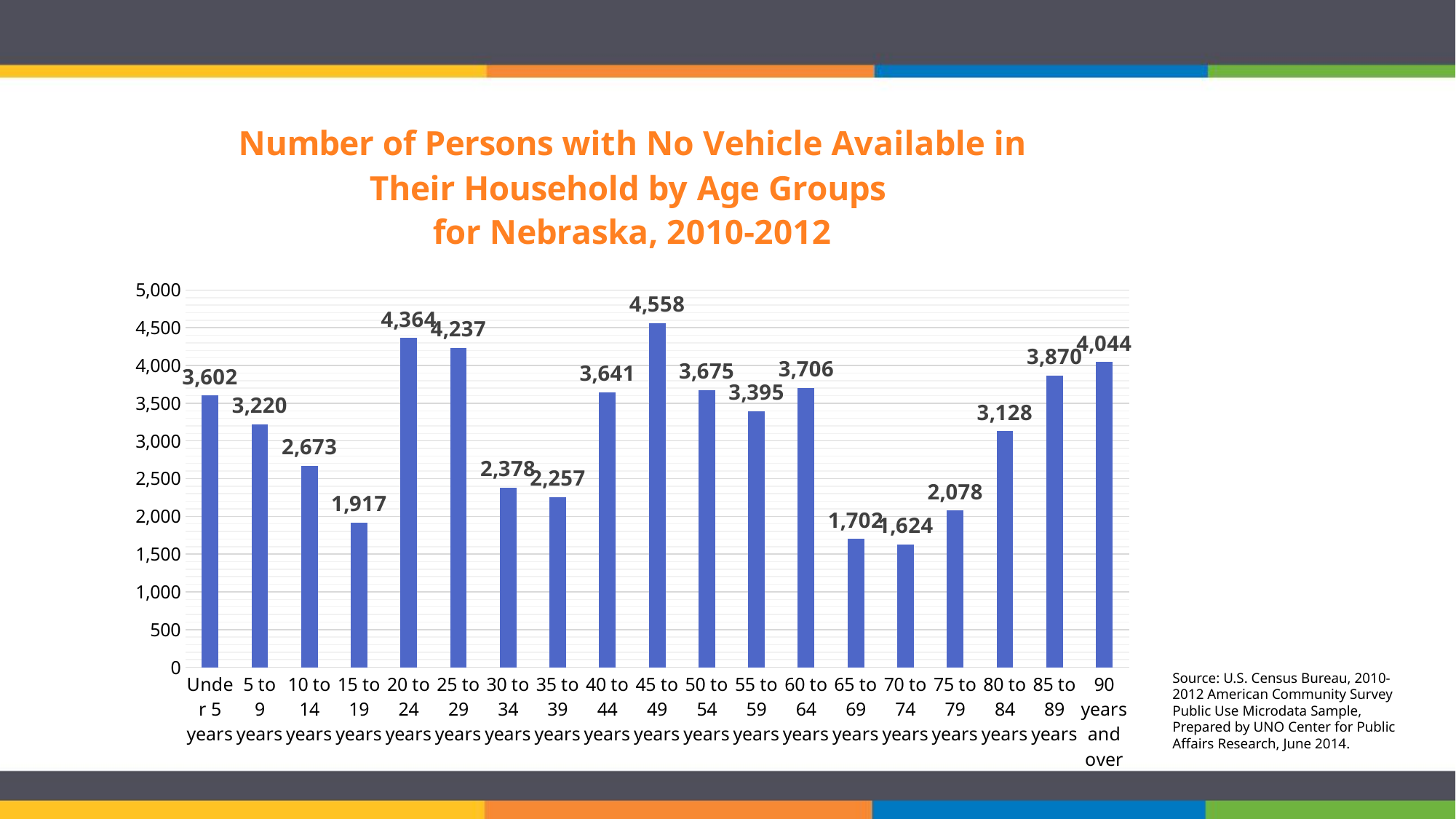
Which age group has the highest number of persons with no vehicle available? 45 to 49 years Is the value for the 80 to 84 years age group greater or less than 3,000? greater What is the value shown for the 90 years and over age group? 4,044 What is the number of persons with no vehicle available for the 45 to 49 years age group? 4,558 What is the value shown for the 15 to 19 years age group? 1,917 What is the difference between the values for the 20 to 24 years and 25 to 29 years age groups? 127 What kind of chart is shown on the slide? Bar chart Which age group has a larger value, 60 to 64 years or 50 to 54 years? 60 to 64 years Do the values rise or fall from the 60 to 64 years group to the 70 to 74 years group? Fall What is the title of the chart? Number of Persons with No Vehicle Available in Their Household by Age Groups for Nebraska, 2010-2012 How many age groups are shown on the chart? 19 Which age group has the lowest number of persons with no vehicle available? 70 to 74 years